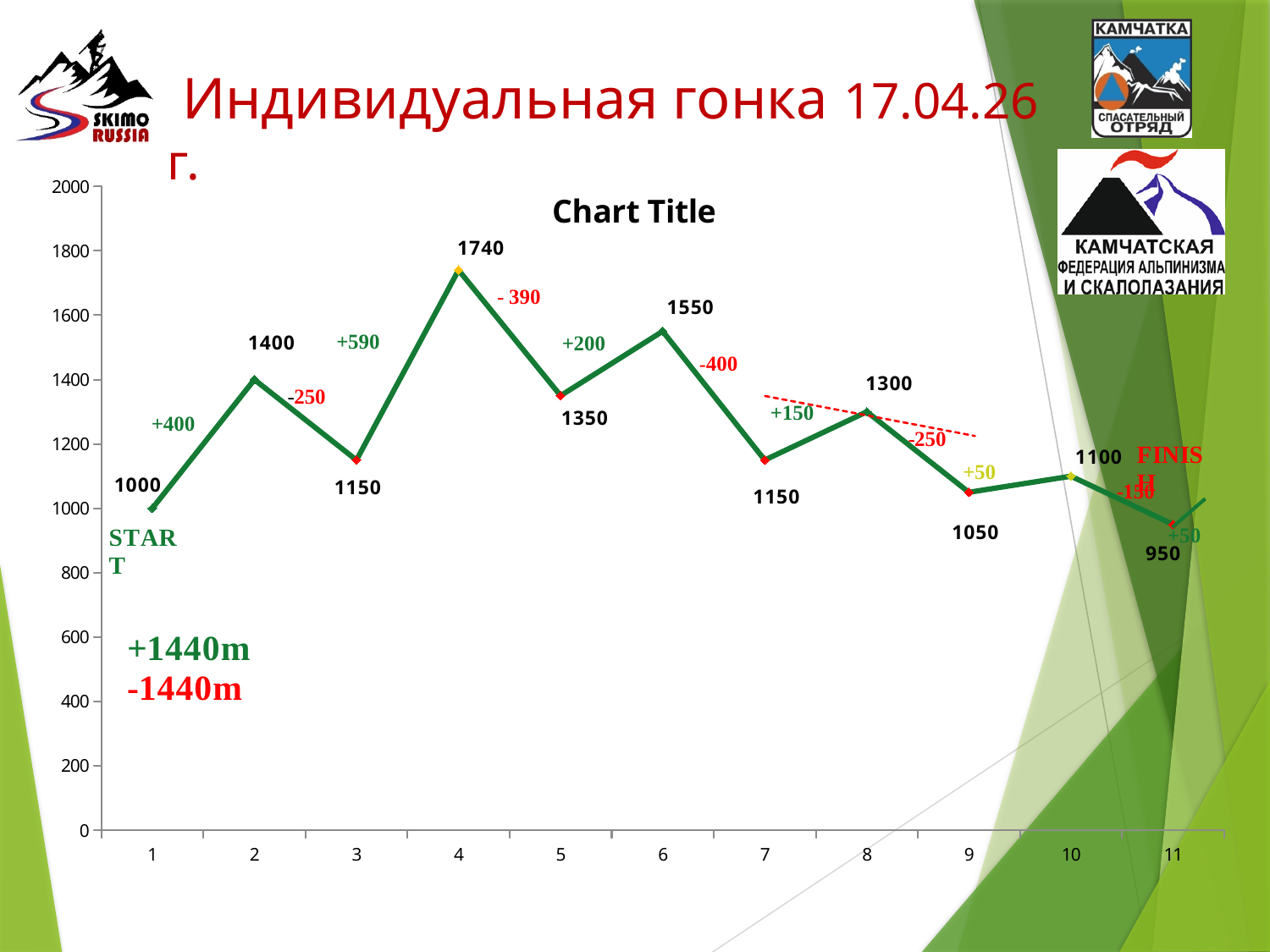
What is the title of the chart? Chart Title How many points are plotted on the line? 11 What is the difference between the values at point 2 and point 1? 400 What is the difference between the values at point 4 and point 5? 390 What is the value at point 8? 1300 Which point has the highest value? 4 What is the value at point 11? 950 Which is larger, the value at point 6 or the value at point 8? point 6 What kind of chart is shown? line chart What is the value at point 1? 1000 Which point has the lowest value? 11 What is the value at point 4? 1740